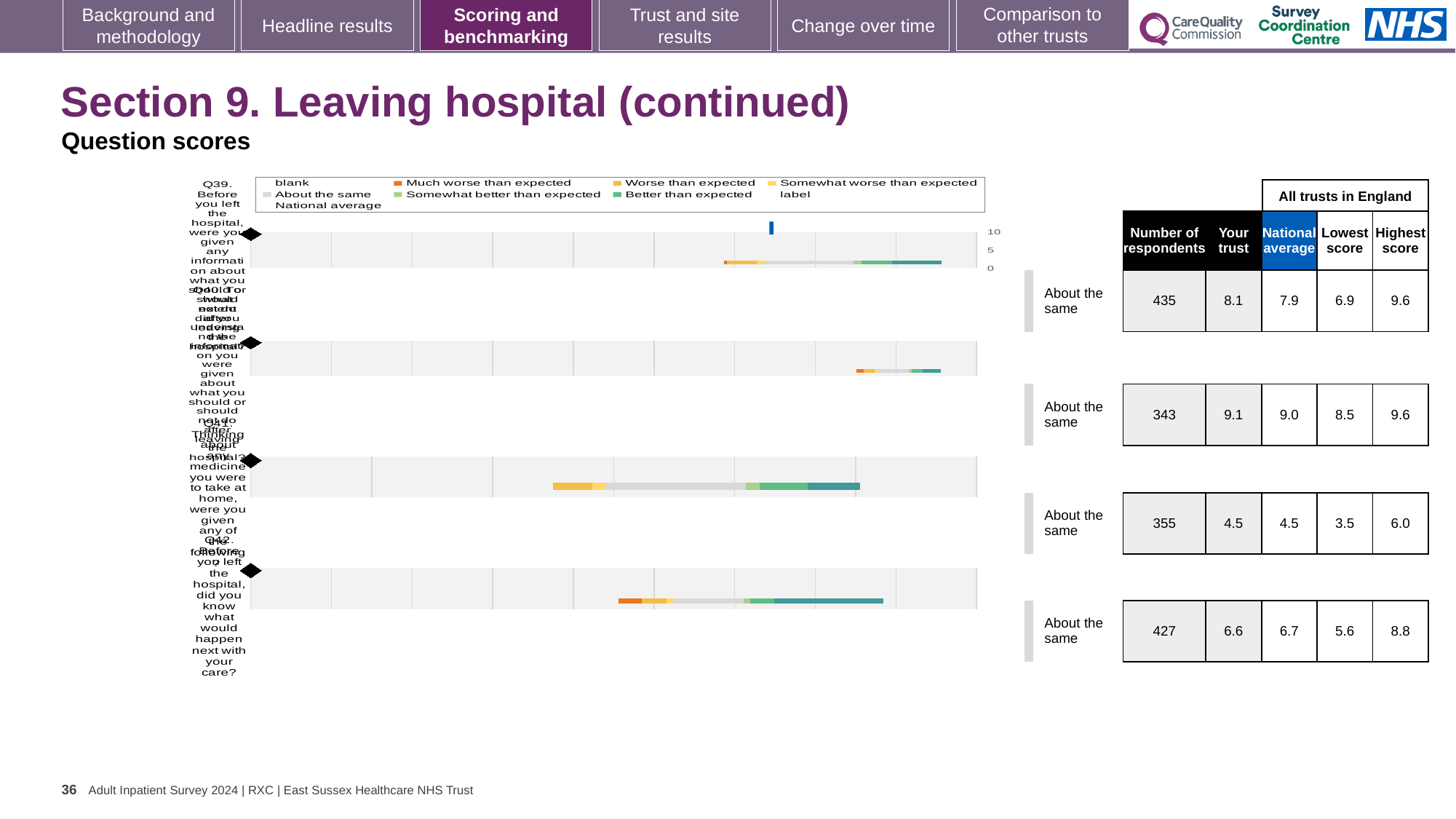
Which row in the table has the highest 'Your trust' score? Q40 (second row), 9.1 For the fourth row (Q42), which is larger: the 'Your trust' score or the national average? National average (6.7) What is the difference between the 'Your trust' score and the national average for the first row (Q39)? 0.2 What kind of chart is shown on the left of the slide? bar chart In the table, what is the 'Your trust' score for the second row (Q40)? 9.1 Which row in the table has the lowest 'Your trust' score? Q41 (third row), 4.5 What benchmark category is shown for every question on this slide? About the same In the table, what is the lowest score in England for the first row (Q39)? 6.9 In the table, what is the national average for the third row (Q41)? 4.5 In the table, what is the highest score in England for the fourth row (Q42)? 8.8 In the table, what is the number of respondents for the first row (Q39)? 435 How many question rows (bars) does the chart on the left show? 4